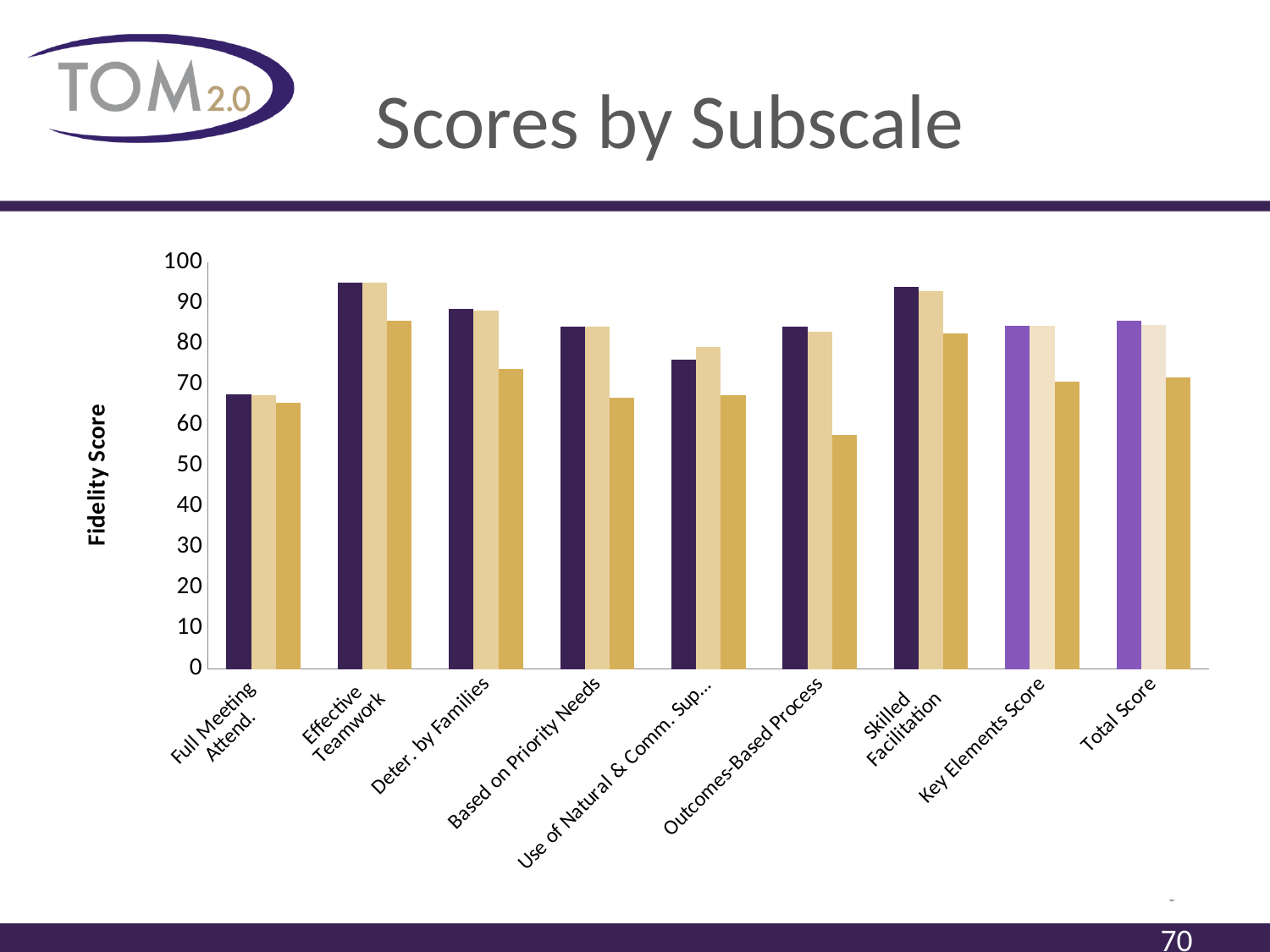
Which category has the lowest dark purple (leftmost) bar? Full Meeting Attend. How many categories are shown along the x axis of the chart? 9 Is the value of the gold (rightmost) bar for Outcomes-Based Process greater or less than 60? less Is the value of the dark purple bar for Full Meeting Attend. greater or less than 60? greater For Outcomes-Based Process, which is larger: the dark purple bar or the gold bar? the dark purple bar Is the value of the gold (rightmost) bar for Skilled Facilitation greater or less than 70? greater What is the title of the slide containing the chart? Scores by Subscale Which category has the lowest gold (rightmost) bar? Outcomes-Based Process How many bars are plotted for each category in the chart? 3 What kind of chart is shown on the slide? bar chart What is the label of the vertical axis of the chart? Fidelity Score